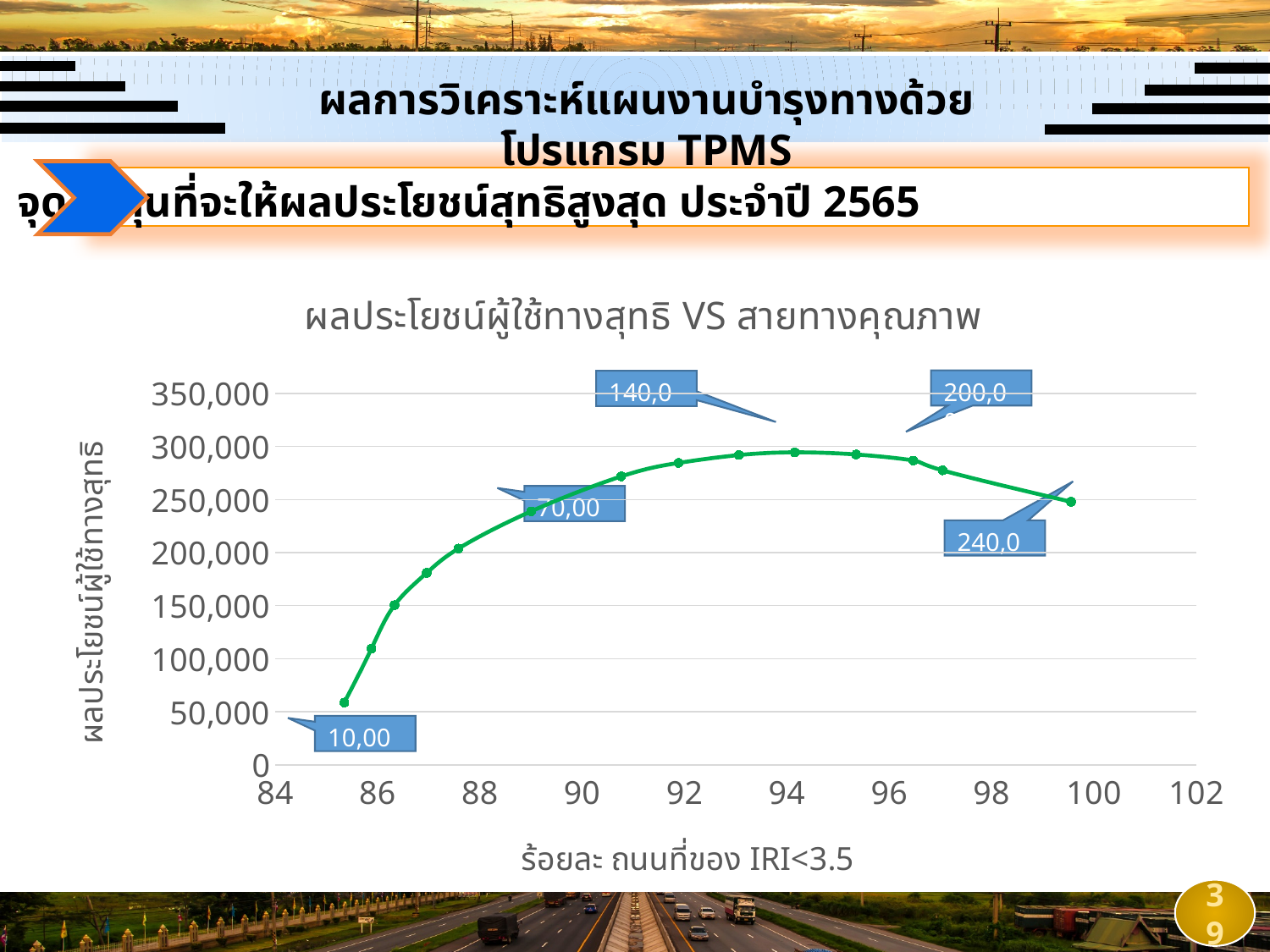
What is the label of the x axis of the chart? ร้อยละ ถนนที่ของ IRI<3.5 How do the values change as the x axis goes from 84 to about 94? they rise Is the value of the last (rightmost) point on the curve greater or less than 200,000? greater What is the highest tick value shown on the y axis? 350,000 How many data points are plotted on the curve? 14 Is the highest point of the curve greater or less than 250,000? greater What kind of chart is shown on the slide? line chart What is the title of the chart? ผลประโยชน์ผู้ใช้ทางสุทธิ VS สายทางคุณภาพ How do the values change as the x axis goes from about 94 to 100? they fall Is the value of the first (leftmost) point on the curve greater or less than 100,000? less